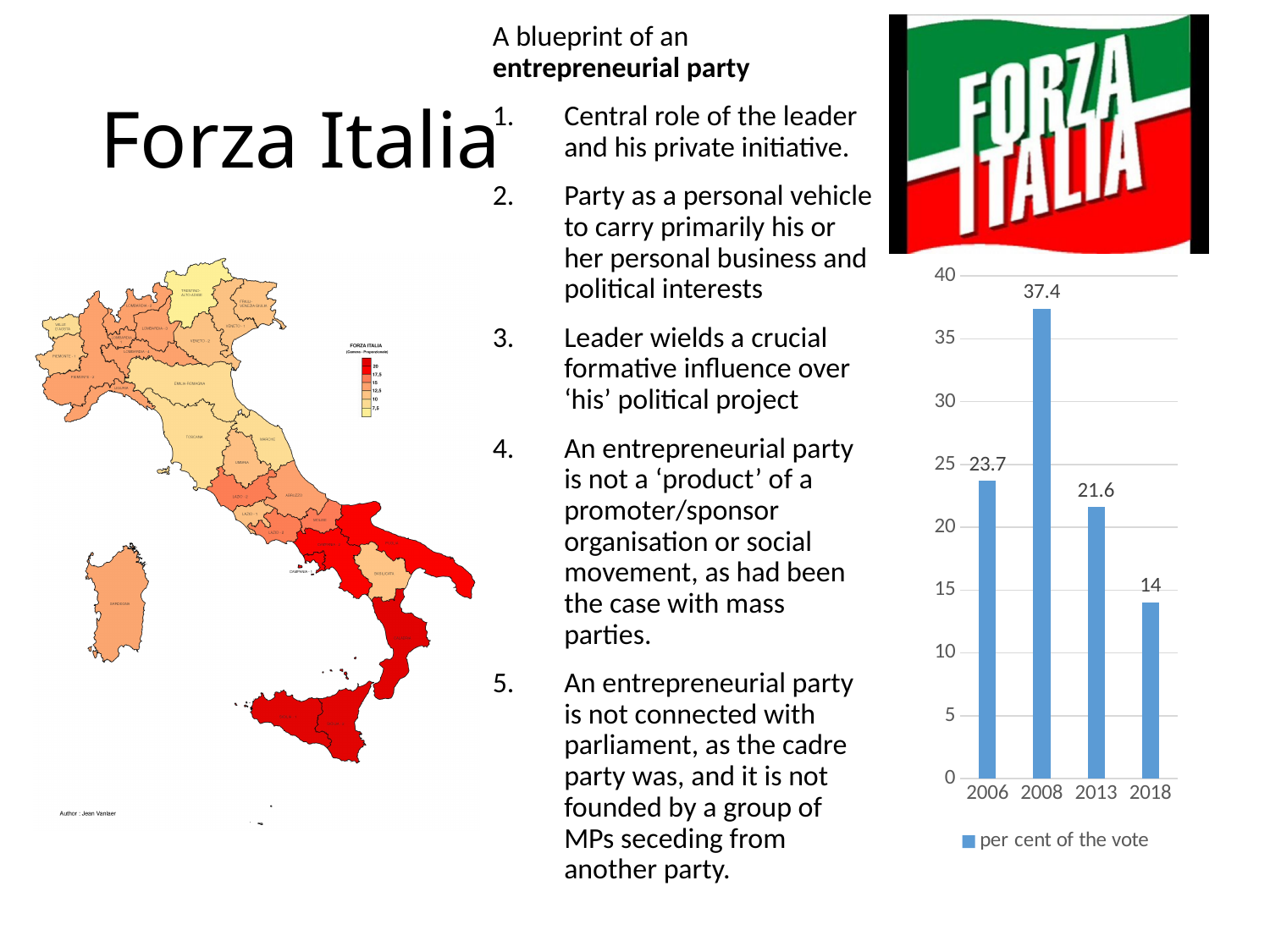
What is the per cent of the vote for 2018? 14 What is the difference between the per cent of the vote in 2013 and 2018? 7.6 How many years are shown in the bar chart? 4 What kind of chart shows the per cent of the vote? bar chart Which year has the lowest per cent of the vote? 2018 What is the per cent of the vote for 2013? 21.6 What is the per cent of the vote for 2006? 23.7 What series does the legend of the bar chart list? per cent of the vote Which year has the highest per cent of the vote? 2008 What is the per cent of the vote for 2008? 37.4 What is the difference between the per cent of the vote in 2008 and 2006? 13.7 Which year has a larger per cent of the vote, 2006 or 2013? 2006